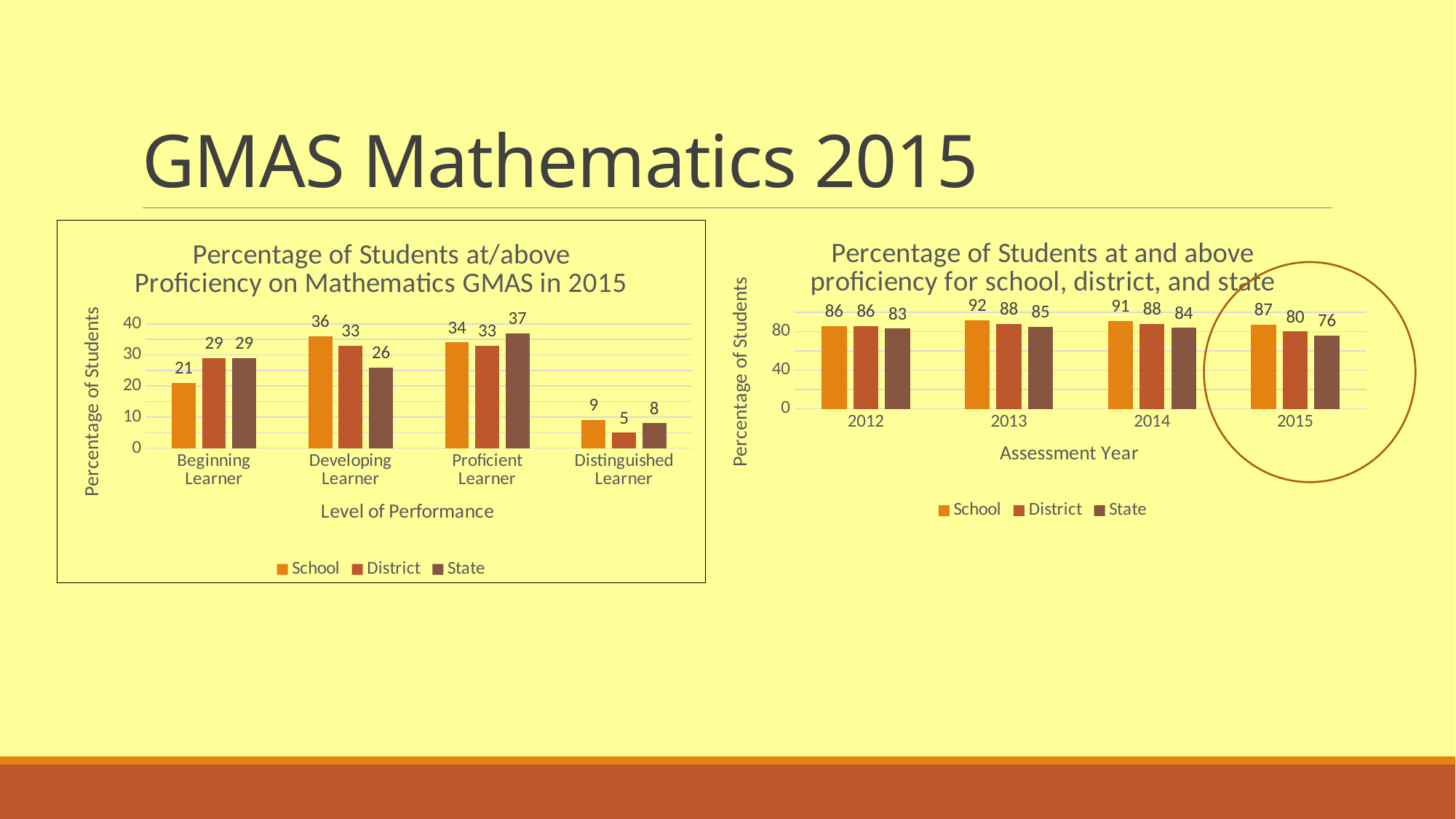
In the left chart, what is the difference between the School and State values for Developing Learner? 10 What kind of chart is the right chart? Bar chart In the left chart, what is the District value for Distinguished Learner? 5 In the left chart, what is the State value for Developing Learner? 26 In the left chart, how many levels of performance are shown on the x axis? 4 In the right chart (Percentage of Students at and above proficiency for school, district, and state), what is the State value for 2015? 76 In the right chart, how many series does the legend list? 3 In the left chart, which level of performance has the highest State value? Proficient Learner In the left chart (Percentage of Students at/above Proficiency on Mathematics GMAS in 2015), what is the School value for Beginning Learner? 21 In the right chart, which year has the lowest District value? 2015 In the right chart, what is the School value for 2013? 92 In the right chart, what is the difference between the School and State values in 2015? 11